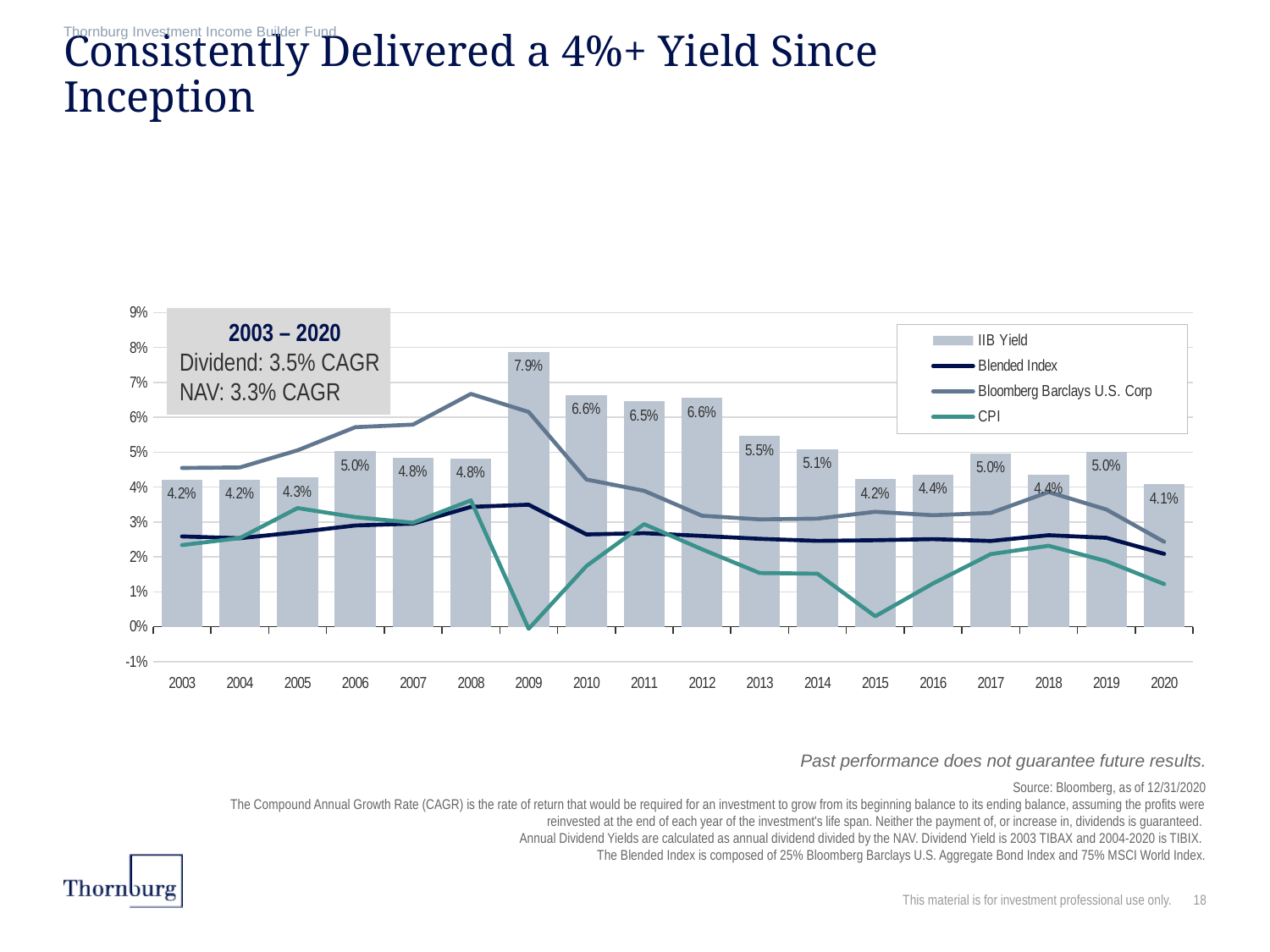
How many years are shown on the x axis of the chart? 18 Which year has the larger IIB Yield, 2010 or 2011? 2010 Which year has the lowest IIB Yield? 2020 Is the Bloomberg Barclays U.S. Corp value for 2008 greater or less than 6%? greater How many series does the legend list? 4 Does the IIB Yield rise or fall from 2009 to 2013? Fall What is the difference between the IIB Yield in 2009 and in 2020? 3.8 percentage points What is the IIB Yield for 2006? 5.0% Is the CPI value for 2009 greater or less than 1%? less Which year has the highest IIB Yield? 2009 What is the IIB Yield for 2009? 7.9% How is the IIB Yield series plotted on the chart? As bars (a bar chart with line series overlaid)